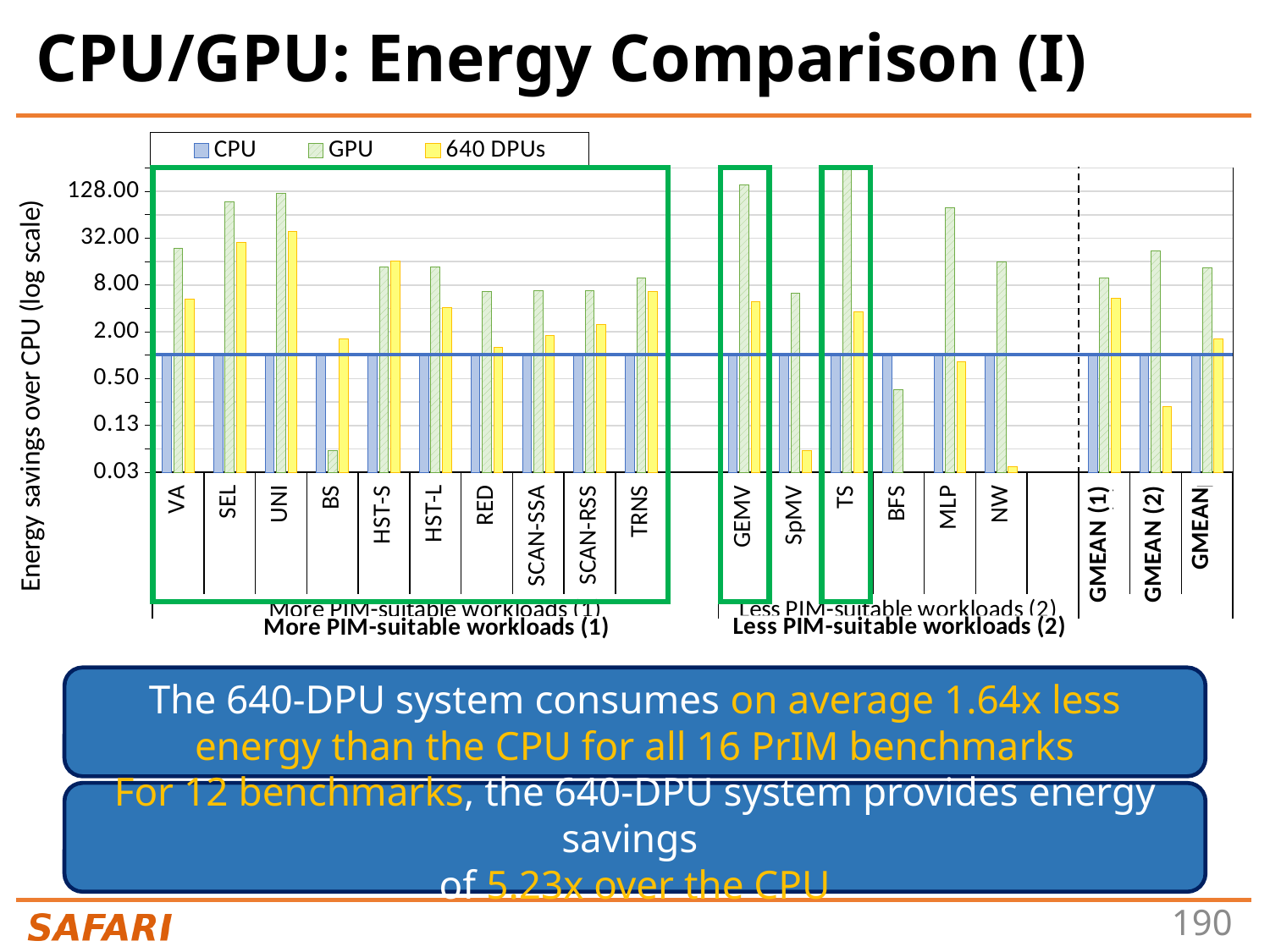
Is the 640 DPUs value for GMEAN (2) greater or less than 0.50? less How many series does the chart legend list? 3 What is the label of the vertical axis of the chart? Energy savings over CPU (log scale) What are the three series named in the chart legend? CPU, GPU, 640 DPUs How many benchmark workloads (excluding the GMEAN categories) are shown on the x axis? 16 Is the 640 DPUs value for VA greater or less than 2.00? greater Is the GPU value for BS greater or less than 0.13? less For BS, which is larger: the GPU value or the 640 DPUs value? 640 DPUs Which benchmark has the highest GPU bar? TS What kind of chart is shown on the slide? bar chart